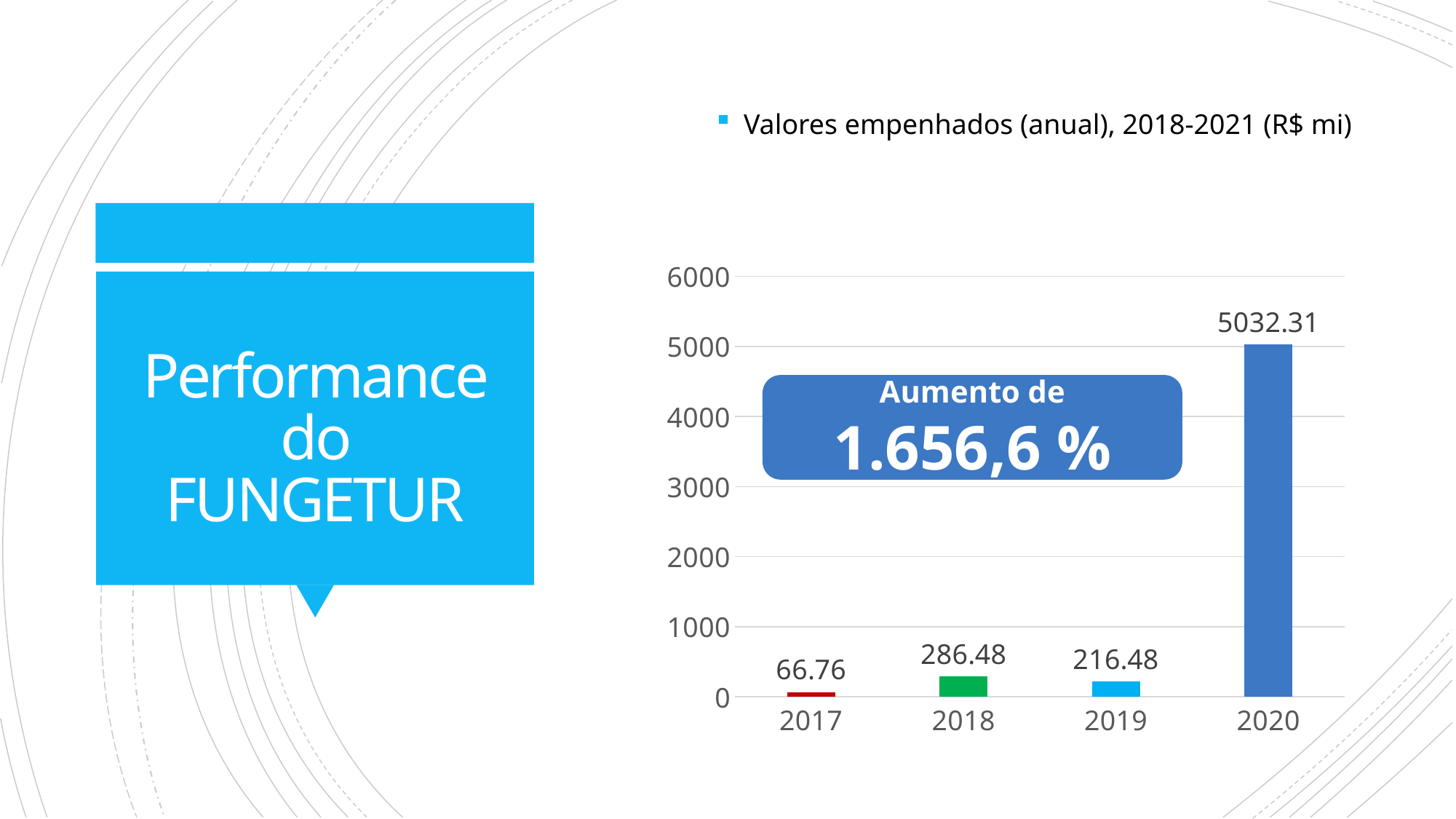
Which year has the lowest value? 2017 What is the value for 2020? 5032.31 How many years are shown on the x axis? 4 What kind of chart is shown on the slide? bar chart What percentage increase is stated in the box on the chart? 1.656,6 % Which year has the highest value? 2020 What is the value for 2019? 216.48 Which is larger, the value for 2018 or the value for 2019? 2018 What is the value for 2017? 66.76 Is the value for 2020 greater or less than 5000? greater What is the value for 2018? 286.48 What is the difference between the values for 2018 and 2019? 70